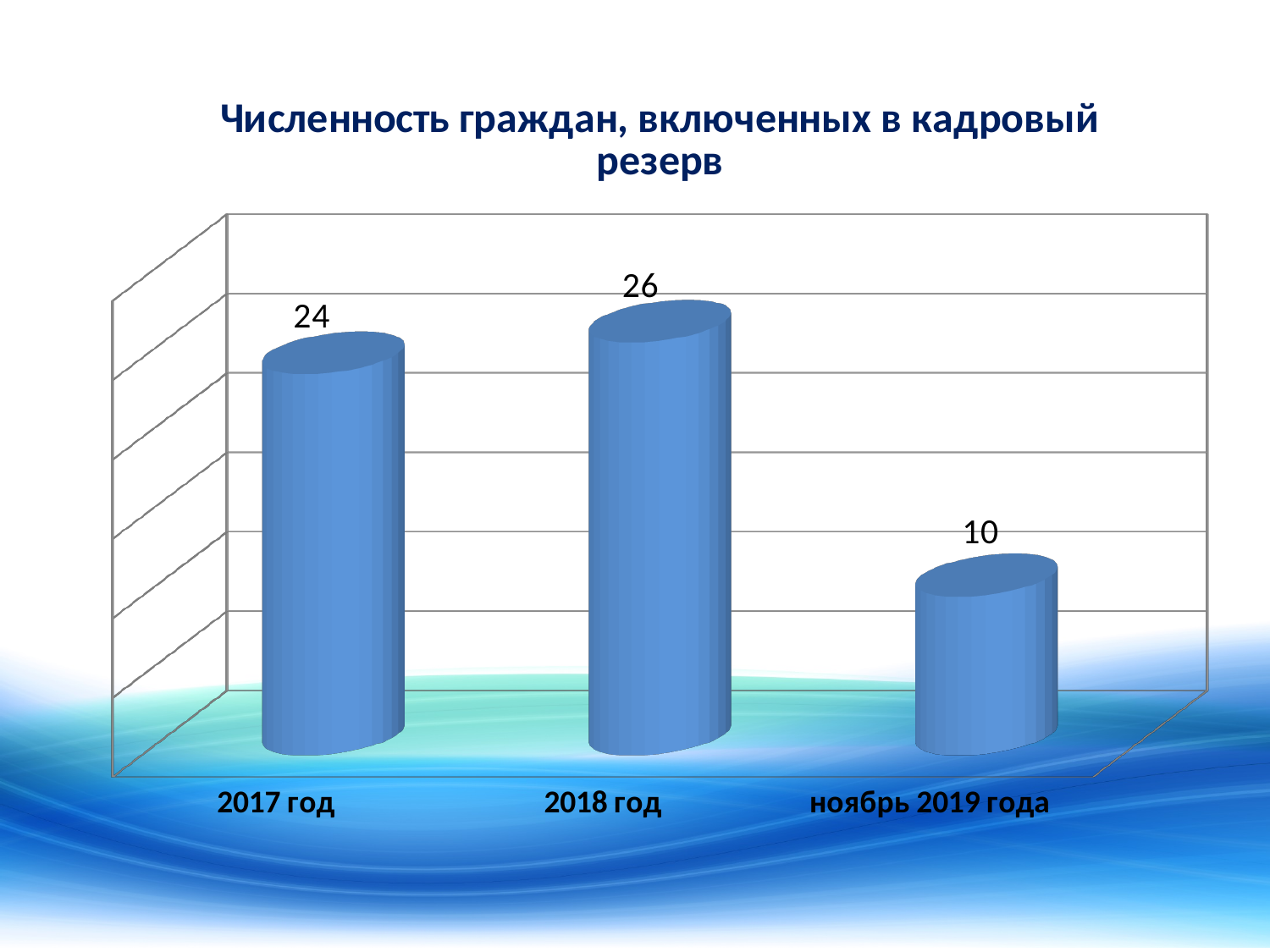
What is the value for 2017 год? 24 What is the value for 2018 год? 26 Does the value rise or fall from 2018 год to ноябрь 2019 года? fall What is the difference between the values for 2018 год and 2017 год? 2 What kind of chart is shown on the slide? bar chart Which category has the lowest value? ноябрь 2019 года How many categories are shown on the x axis? 3 What is the value for ноябрь 2019 года? 10 Which category has the highest value? 2018 год What is the title of the chart? Численность граждан, включенных в кадровый резерв Which is larger, the value for 2017 год or the value for ноябрь 2019 года? 2017 год What is the difference between the values for 2018 год and ноябрь 2019 года? 16